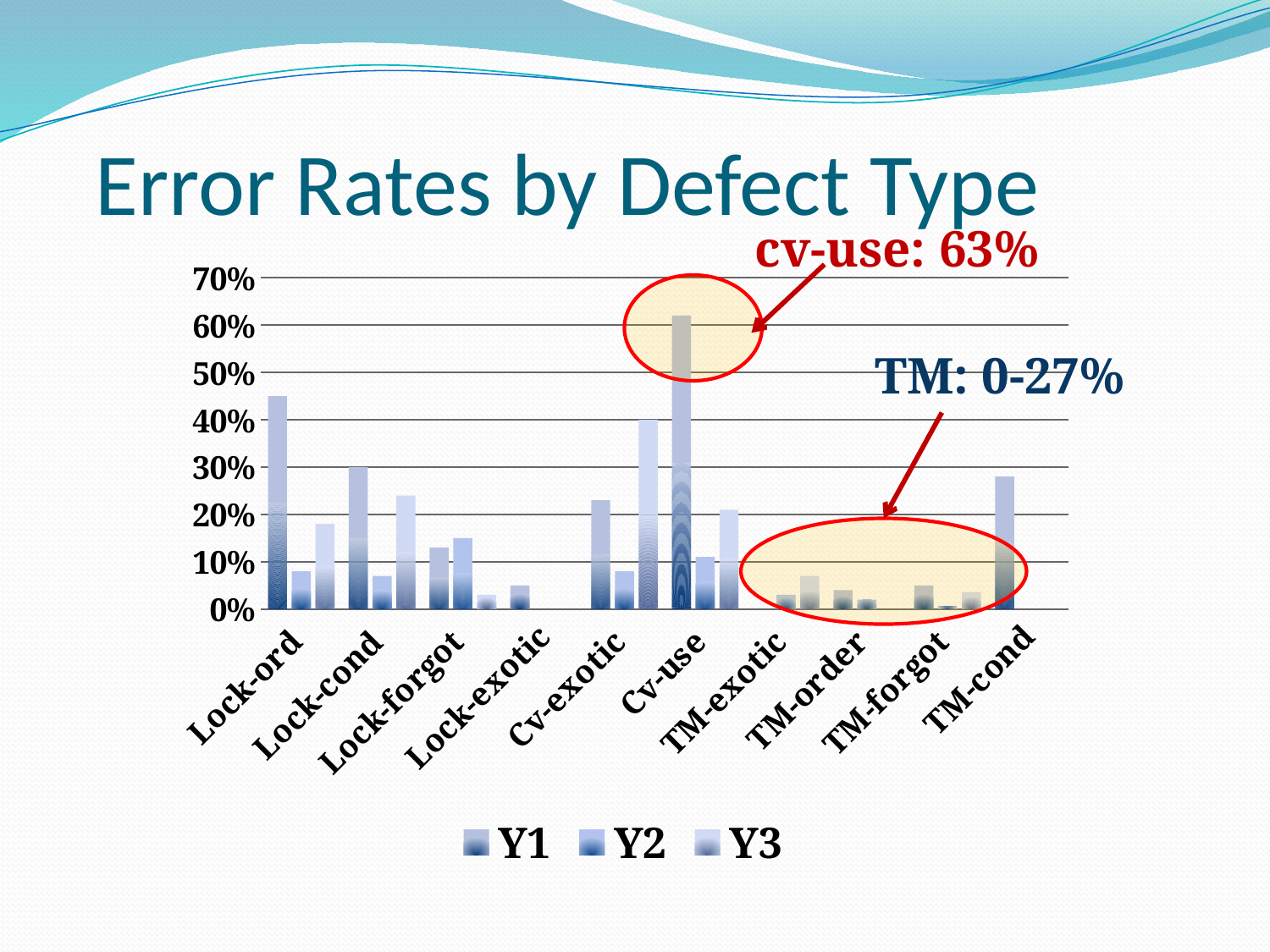
Is the Y1 value for TM-cond greater or less than 20%? greater Which is larger, the Y1 value for Lock-ord or the Y1 value for Lock-cond? Lock-ord How many defect type categories are shown on the x axis? 10 Is the Y1 value for Lock-ord greater or less than 40%? greater How many series does the legend list? 3 Is the Y1 value for Cv-use greater or less than 50%? greater What kind of chart is shown on the slide? bar chart Which defect type has the highest Y1 error rate? Cv-use Which is larger, the Y1 value for Cv-use or the Y3 value for Cv-exotic? Cv-use What error rate does the annotation give for cv-use? 63% What range does the annotation give for the TM defect types? 0-27%